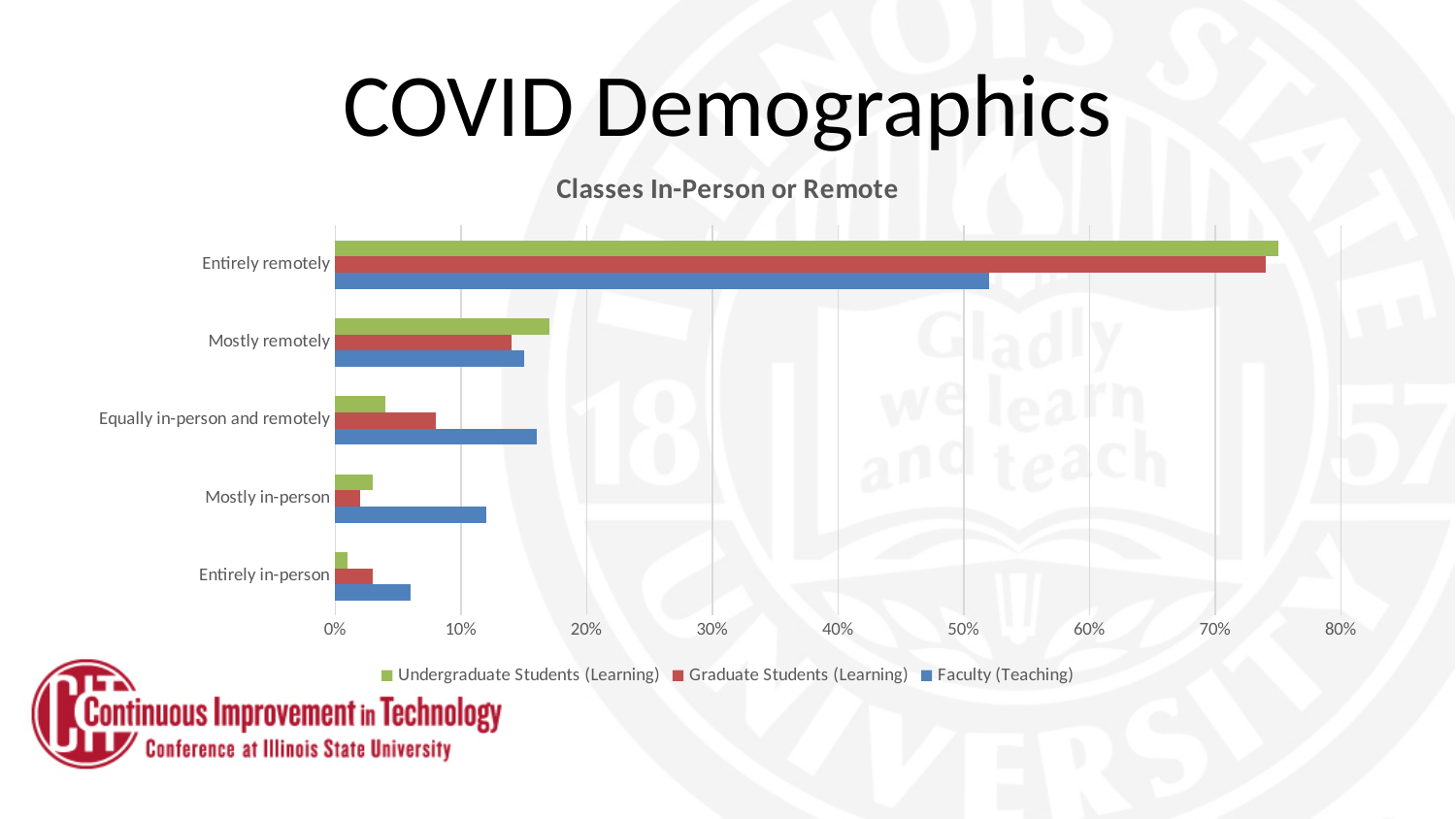
For Mostly in-person, which is larger: Faculty (Teaching) or Graduate Students (Learning)? Faculty (Teaching) How many categories are shown on the vertical axis of the chart? 5 Is the Graduate Students (Learning) value for Mostly remotely greater or less than 20%? less Which category has the lowest value for Undergraduate Students (Learning)? Entirely in-person What is the title of the chart? Classes In-Person or Remote Is the Faculty (Teaching) value for Entirely remotely greater or less than 60%? less How many series does the chart's legend list? 3 For Equally in-person and remotely, which is larger: Faculty (Teaching) or Undergraduate Students (Learning)? Faculty (Teaching) Is the Undergraduate Students (Learning) value for Entirely remotely greater or less than 70%? greater What kind of chart is shown on the slide? bar chart What colour represents Faculty (Teaching) in the chart? blue Which category has the highest value for Faculty (Teaching)? Entirely remotely